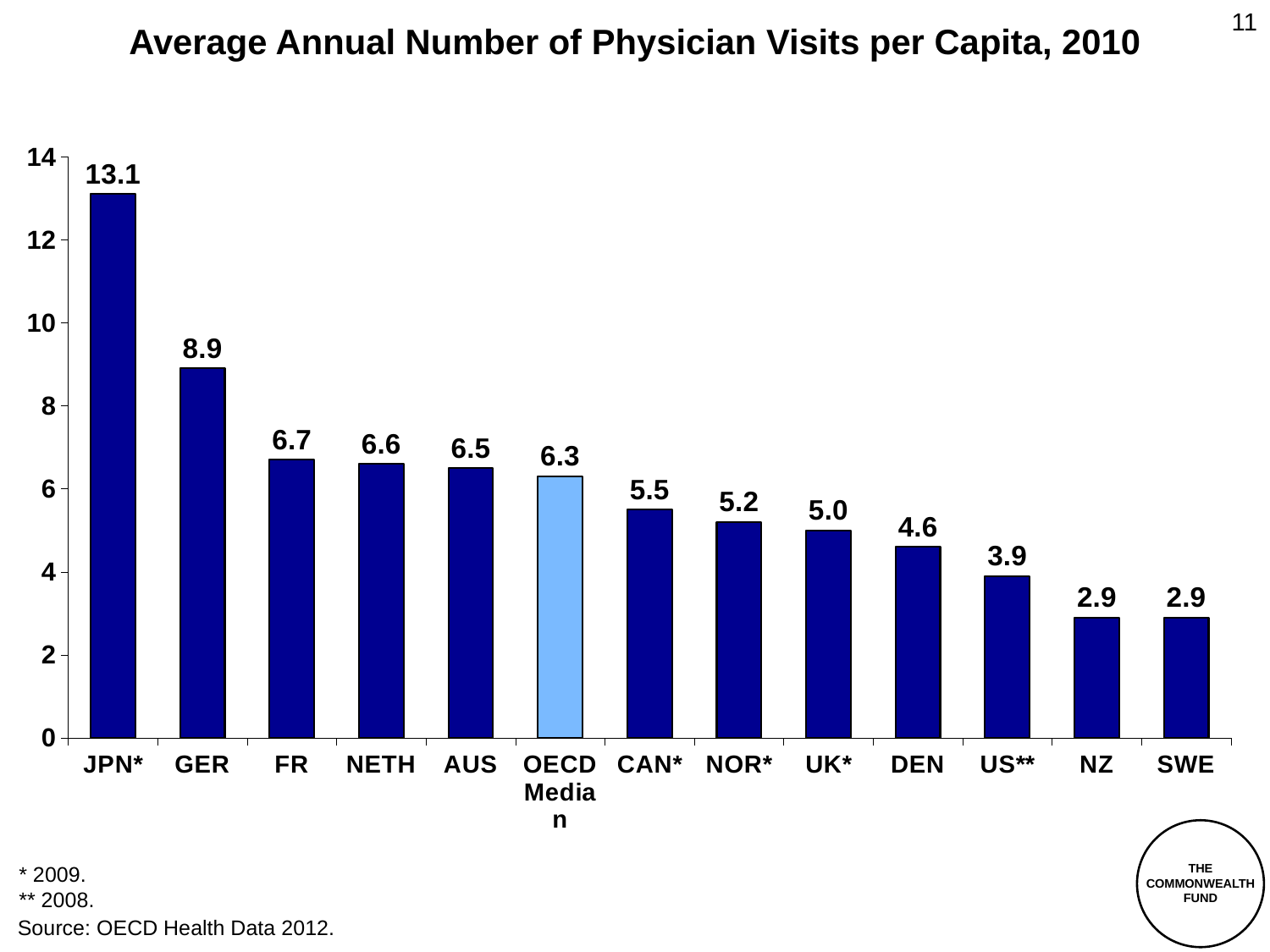
Which bar is shown in a lighter blue colour than the others? OECD Median Which category has the highest number of physician visits per capita? JPN* Which has a larger value, DEN or UK*? UK* What kind of chart is shown on the slide? Bar chart What is the value shown for US**? 3.9 Which categories share the lowest value on the chart? NZ and SWE What is the value shown for the OECD Median? 6.3 What is the difference between the values for JPN* and GER? 4.2 What is the average annual number of physician visits per capita for JPN*? 13.1 Which has a larger value, GER or FR? GER What is the difference between the values for CAN* and US**? 1.6 How many bars are plotted on the chart? 13